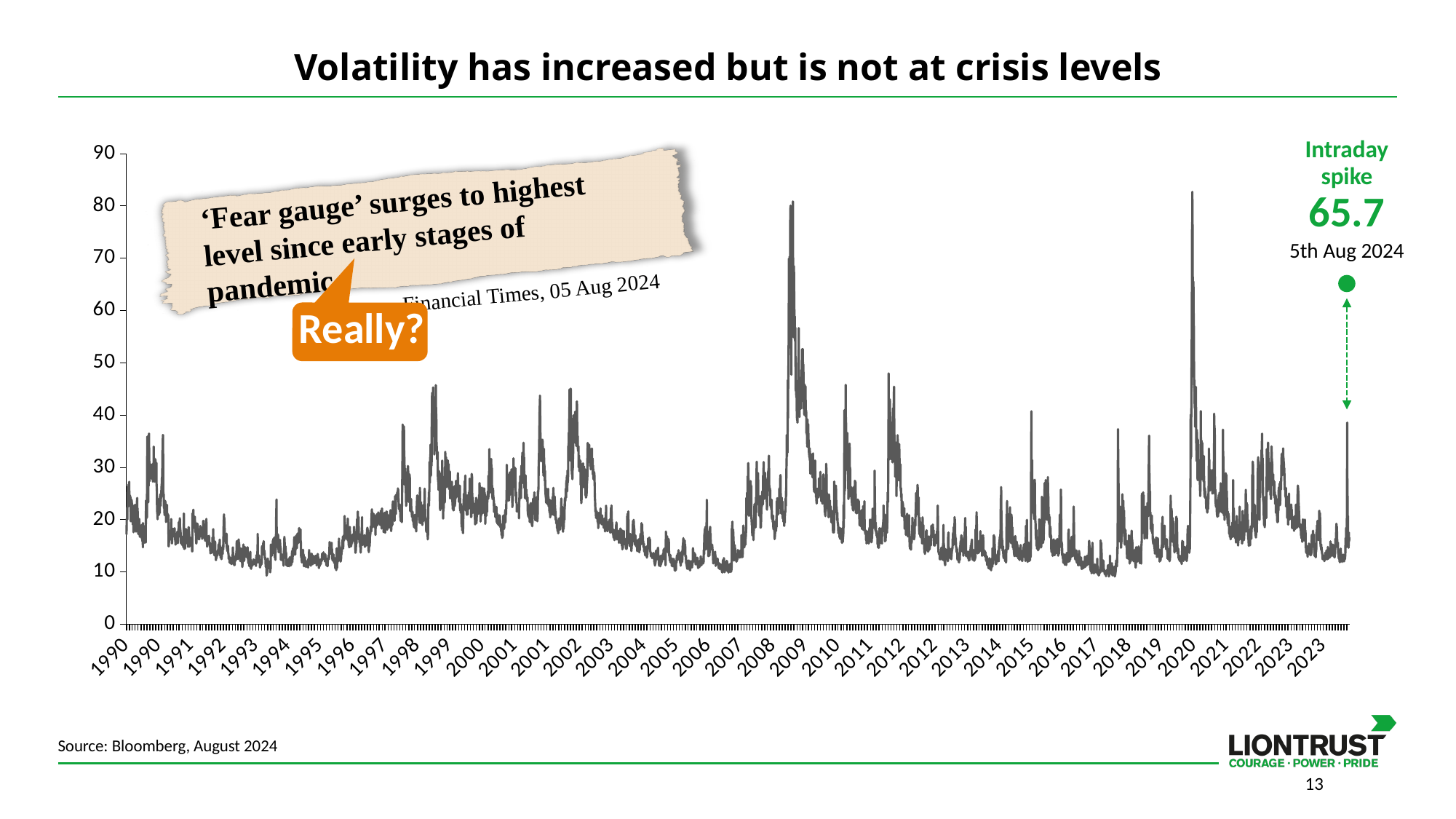
Which is higher: the peak around 2008-2009 or the peak in 2011? The peak around 2008-2009 Is the peak of the line in 2020 greater or less than 70? greater Is the level of the line during 2017 greater or less than 20? less What is the highest value shown on the vertical axis? 90 What is the source given for the chart data? Bloomberg, August 2024 On what date did the intraday spike of 65.7 occur? 5th Aug 2024 What is the title of the slide? Volatility has increased but is not at crisis levels Is the intraday spike of 65.7 higher or lower than the peak of the line in 2020? Lower What kind of chart is shown on the slide? Line chart Is the peak of the line around 2008-2009 greater or less than 70? greater What value is given for the intraday spike on 5th Aug 2024? 65.7